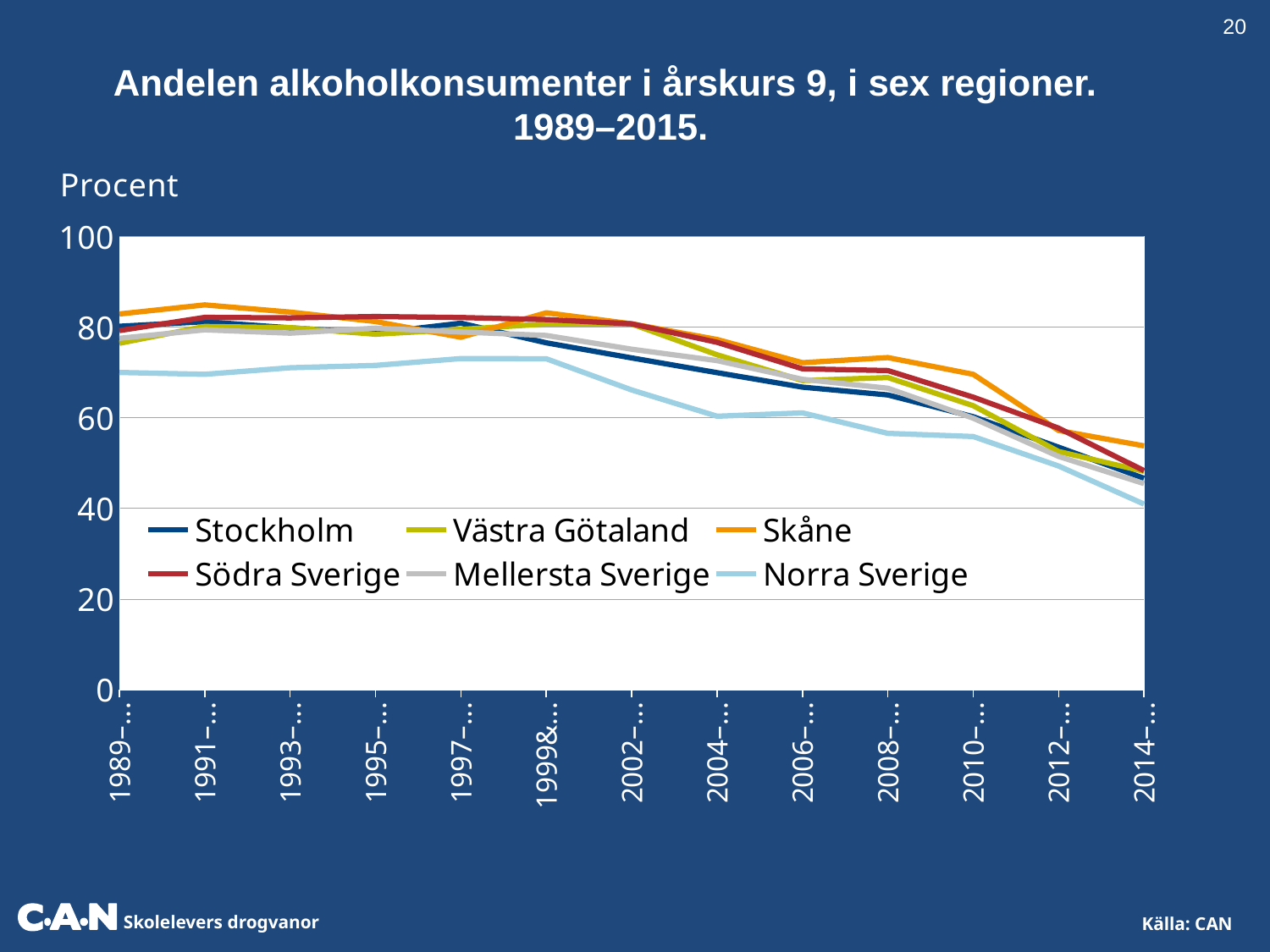
What kind of chart is shown on the slide? line chart Is the value for Skåne in 2014 greater or less than 40? greater Which series is the lowest at the start of the period (1989)? Norra Sverige What is the title of the chart? Andelen alkoholkonsumenter i årskurs 9, i sex regioner. 1989–2015. Is the value for Skåne in 1991 greater or less than 80? greater In 1989, which is larger: the value for Skåne or the value for Norra Sverige? Skåne What unit label is shown above the y axis? Procent Is the value for Norra Sverige in 1989 greater or less than 80? less Which series is the lowest at the end of the period (2014)? Norra Sverige How many series does the legend list? 6 Do the values generally rise or fall from 1989 to 2014? fall Which series is the highest at the end of the period (2014)? Skåne